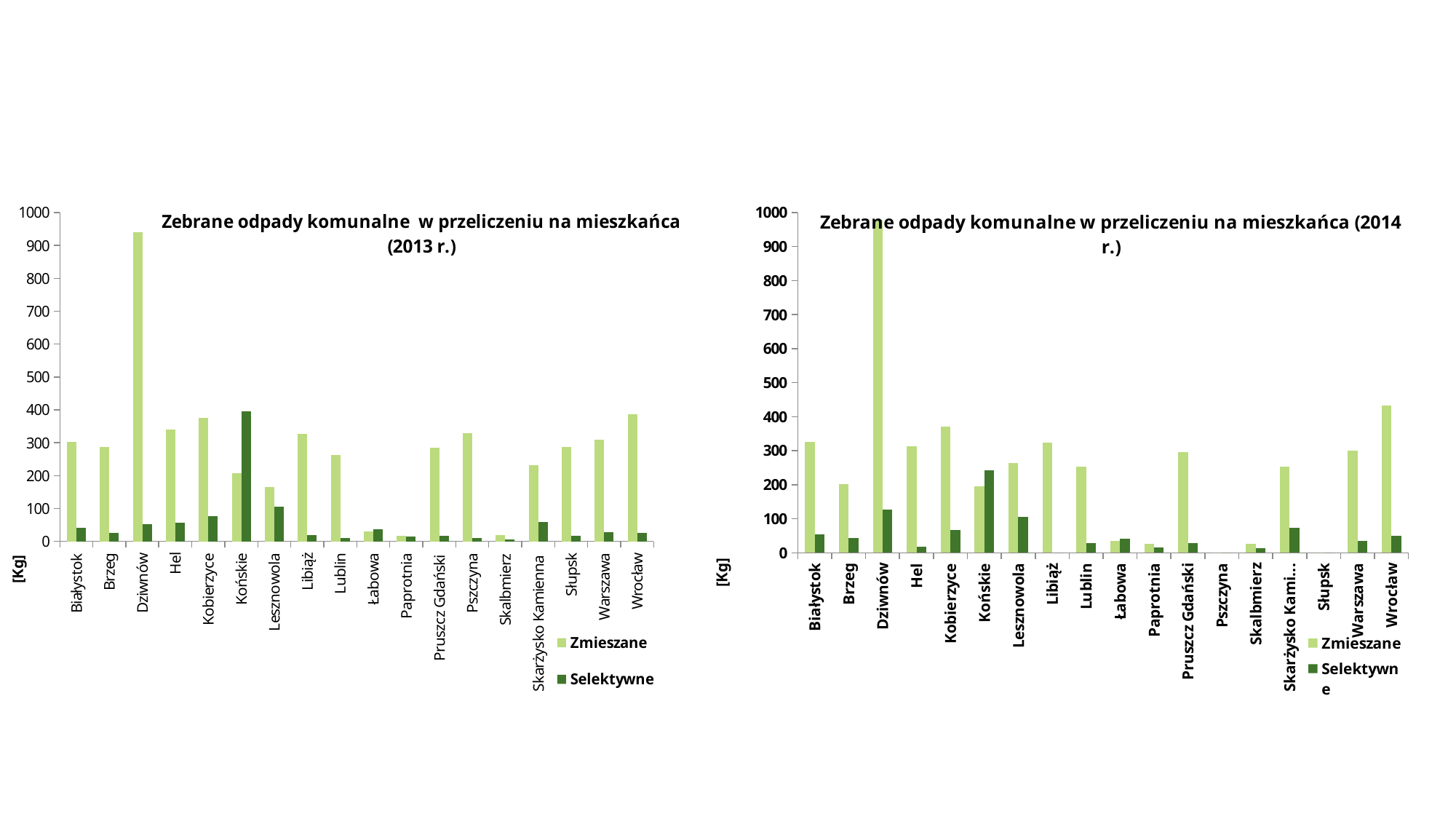
In the right chart (2014 r.), is the Selektywne value for Końskie greater or less than 200? greater In the left chart (2013 r.), is the Zmieszane value for Lesznowola greater or less than 200? less What unit is shown on the y axis label of the left chart (2013 r.)? [Kg] In the right chart (2014 r.), which locality has the highest Selektywne value? Końskie How many categories (localities) are shown on the x axis of the left chart (2013 r.)? 18 In the left chart (2013 r.), is the Zmieszane value for Dziwnów greater or less than 900? greater In the left chart (2013 r.), which locality has the highest Selektywne value? Końskie In the right chart (2014 r.), which is larger for Końskie: the Zmieszane value or the Selektywne value? Selektywne What kind of chart is the left chart (2013 r.)? bar chart In the right chart (2014 r.), which locality has the highest Zmieszane value? Dziwnów How many series does the legend of the right chart (2014 r.) list? 2